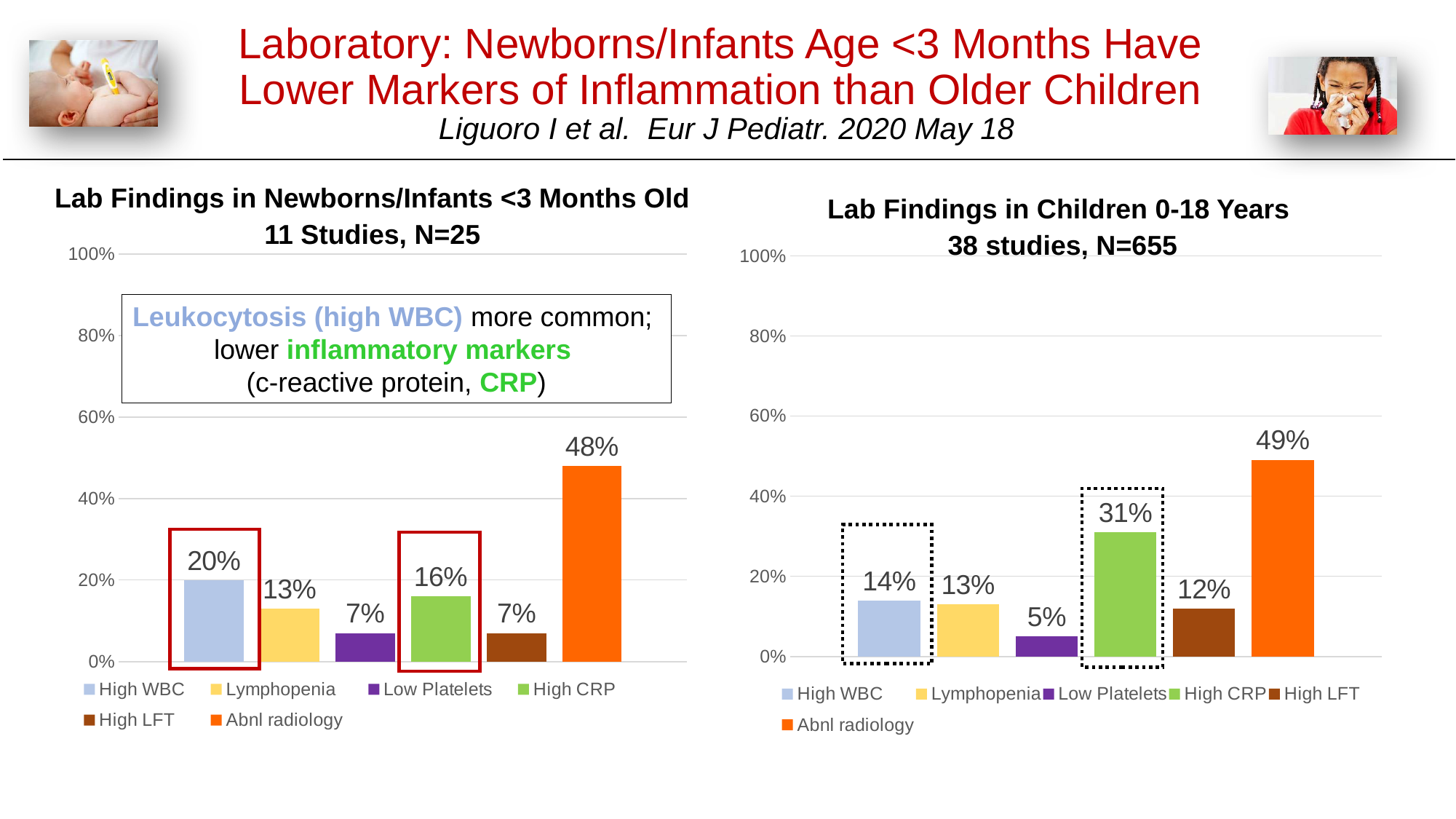
How many categories are plotted in the 'Lab Findings in Children 0-18 Years' chart? 6 In the 'Lab Findings in Children 0-18 Years' chart, which category has the lowest value? Low Platelets In the 'Lab Findings in Newborns/Infants <3 Months Old' chart, what is the difference between High WBC and High CRP? 4% In the 'Lab Findings in Newborns/Infants <3 Months Old' chart, what is the value for Lymphopenia? 13% In the 'Lab Findings in Newborns/Infants <3 Months Old' chart, which category has the highest value? Abnl radiology How many entries does the legend of the 'Lab Findings in Children 0-18 Years' chart list? 6 In the 'Lab Findings in Newborns/Infants <3 Months Old' chart, is the value for Abnl radiology greater or less than 40%? greater In the 'Lab Findings in Children 0-18 Years' chart, what is the value for High CRP? 31% In the 'Lab Findings in Children 0-18 Years' chart, what is the difference between Abnl radiology and High CRP? 18% In the 'Lab Findings in Newborns/Infants <3 Months Old' chart, what is the value for High WBC? 20% Which is larger in the 'Lab Findings in Children 0-18 Years' chart: High WBC or High CRP? High CRP What kind of chart is 'Lab Findings in Newborns/Infants <3 Months Old'? Bar chart